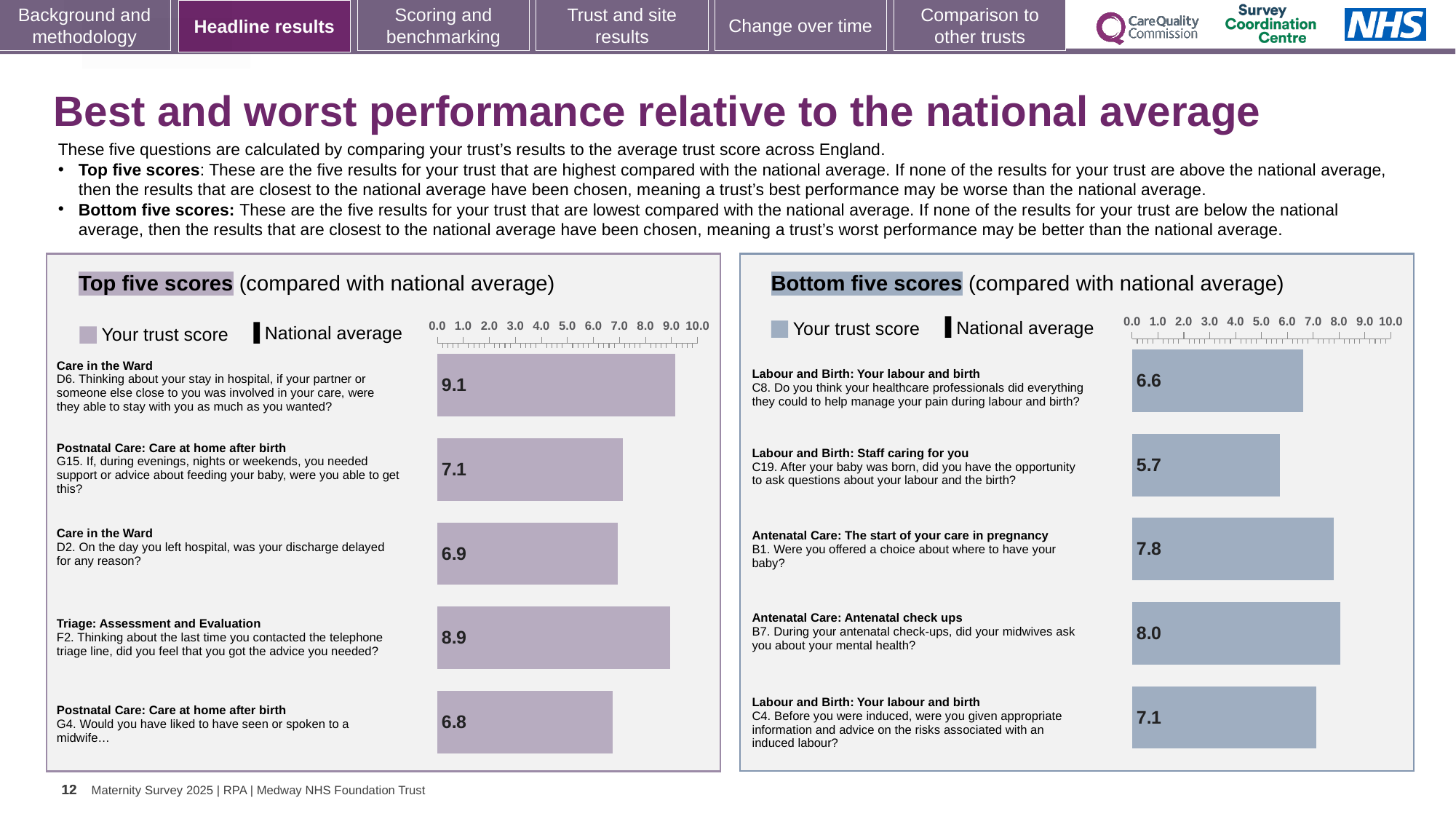
In the Top five scores chart, is the trust score for F2 greater or less than 8.0? greater In the Top five scores chart, which question has the highest trust score? D6 (Care in the Ward) How many entries does the legend of the Bottom five scores chart list? 2 In the Top five scores chart, what is the difference between the trust scores for D6 and G4? 2.3 How many bars are plotted in the Top five scores chart? 5 In the Bottom five scores chart, what is the trust score for question C19 (Labour and Birth: Staff caring for you)? 5.7 In the Top five scores chart, what is the trust score for question D6 (Care in the Ward)? 9.1 In the Bottom five scores chart, which has the larger trust score, B7 or B1? B7 What is the maximum value shown on the axis of the Bottom five scores chart? 10.0 What type of chart is used in the Top five scores panel? Bar chart In the Bottom five scores chart, what is the trust score for question B7 (Antenatal check ups)? 8.0 In the Bottom five scores chart, which question has the lowest trust score? C19 (Labour and Birth: Staff caring for you)